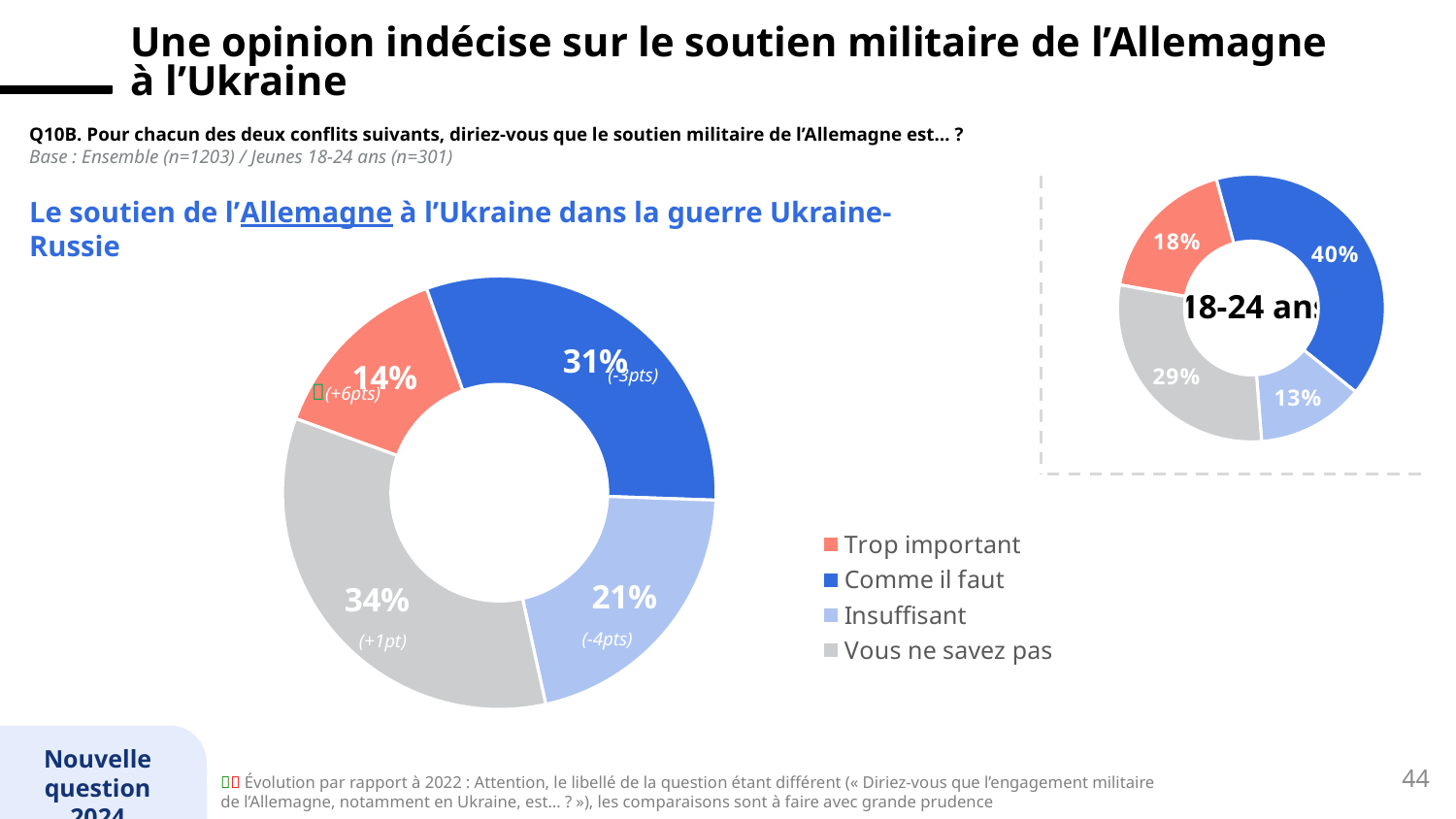
On the main donut chart (Ensemble), which response has the smallest share? Trop important On the small "18-24 ans" donut chart, what share answered "Insuffisant"? 13% On the main donut chart (Ensemble), what share of respondents answered "Vous ne savez pas"? 34% On the main donut chart (Ensemble), what share of respondents answered "Trop important"? 14% Which is larger: the "Comme il faut" share on the main chart (Ensemble) or on the "18-24 ans" chart? 18-24 ans What type of chart is used on this slide? Donut (pie) chart On the main donut chart (Ensemble), what is the difference between the "Vous ne savez pas" share and the "Insuffisant" share? 13 points On the main donut chart (Ensemble), what share of respondents answered "Comme il faut"? 31% On the small "18-24 ans" donut chart, which response has the smallest share? Insuffisant On the main donut chart (Ensemble), which response has the largest share? Vous ne savez pas How many response categories does the legend list? 4 On the small "18-24 ans" donut chart, what share answered "Comme il faut"? 40%